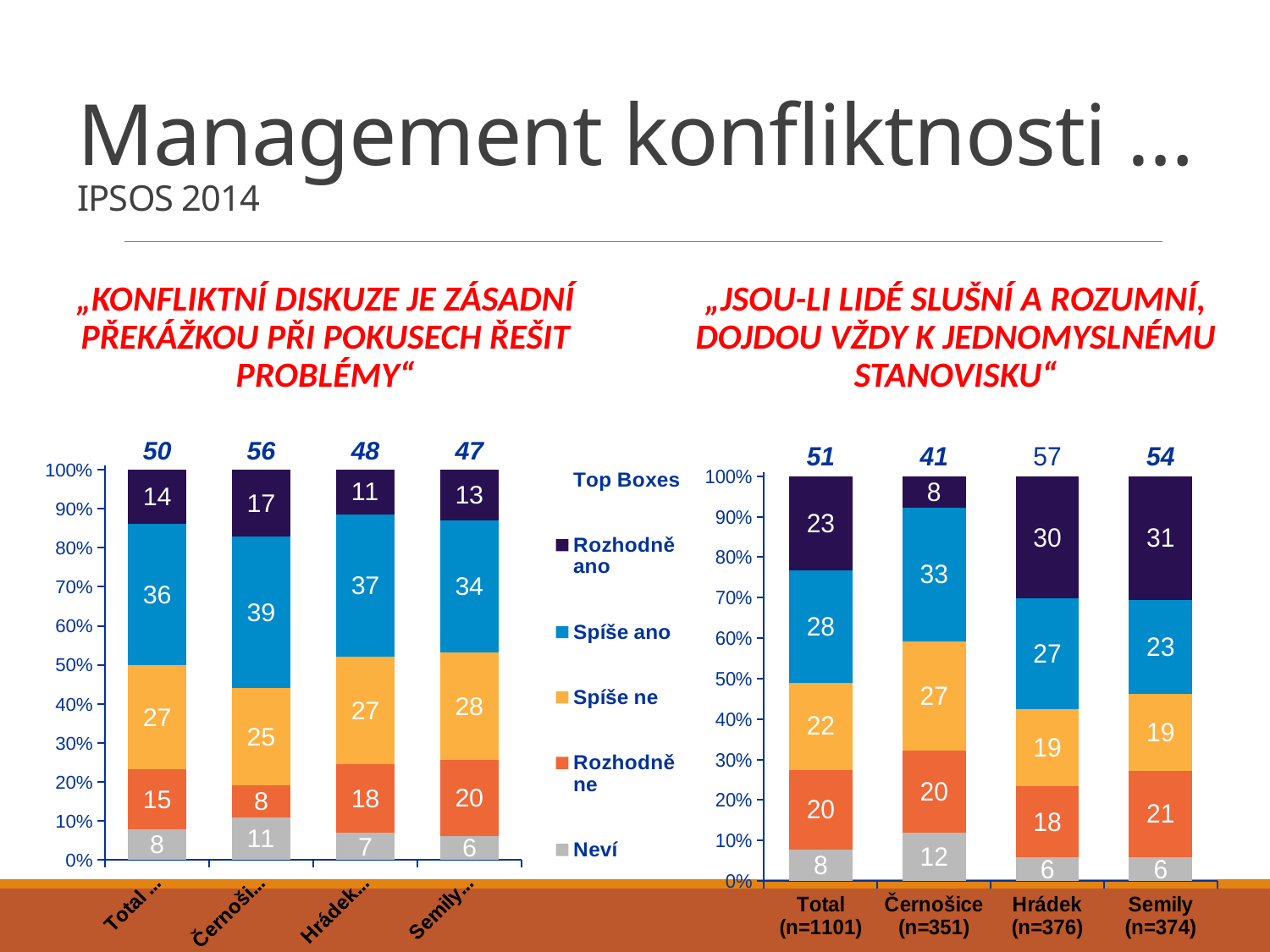
In the left chart, what is the Rozhodně ne value for Total? 15 How many series does the legend list? 6 In the right chart, what is the Neví value for Černošice (n=351)? 12 In the right chart, which category has the highest Top Boxes value? Hrádek (n=376) In the right chart, which has the larger Spíše ano value: Total (n=1101) or Černošice (n=351)? Černošice (n=351) In the right chart, which category has the lowest Top Boxes value? Černošice (n=351) In the right chart, what is the difference between the Rozhodně ano values for Semily (n=374) and Total (n=1101)? 8 In the right chart ("Jsou-li lidé slušní a rozumní..."), what is the Rozhodně ano value for Hrádek (n=376)? 30 In the left chart ("Konfliktní diskuze je zásadní překážkou..."), what is the Top Boxes value above the Total bar? 50 What kind of chart is used on this slide? Stacked bar chart In the right chart, what is the Top Boxes value shown above the Černošice (n=351) bar? 41 How many categories are shown in the right chart? 4